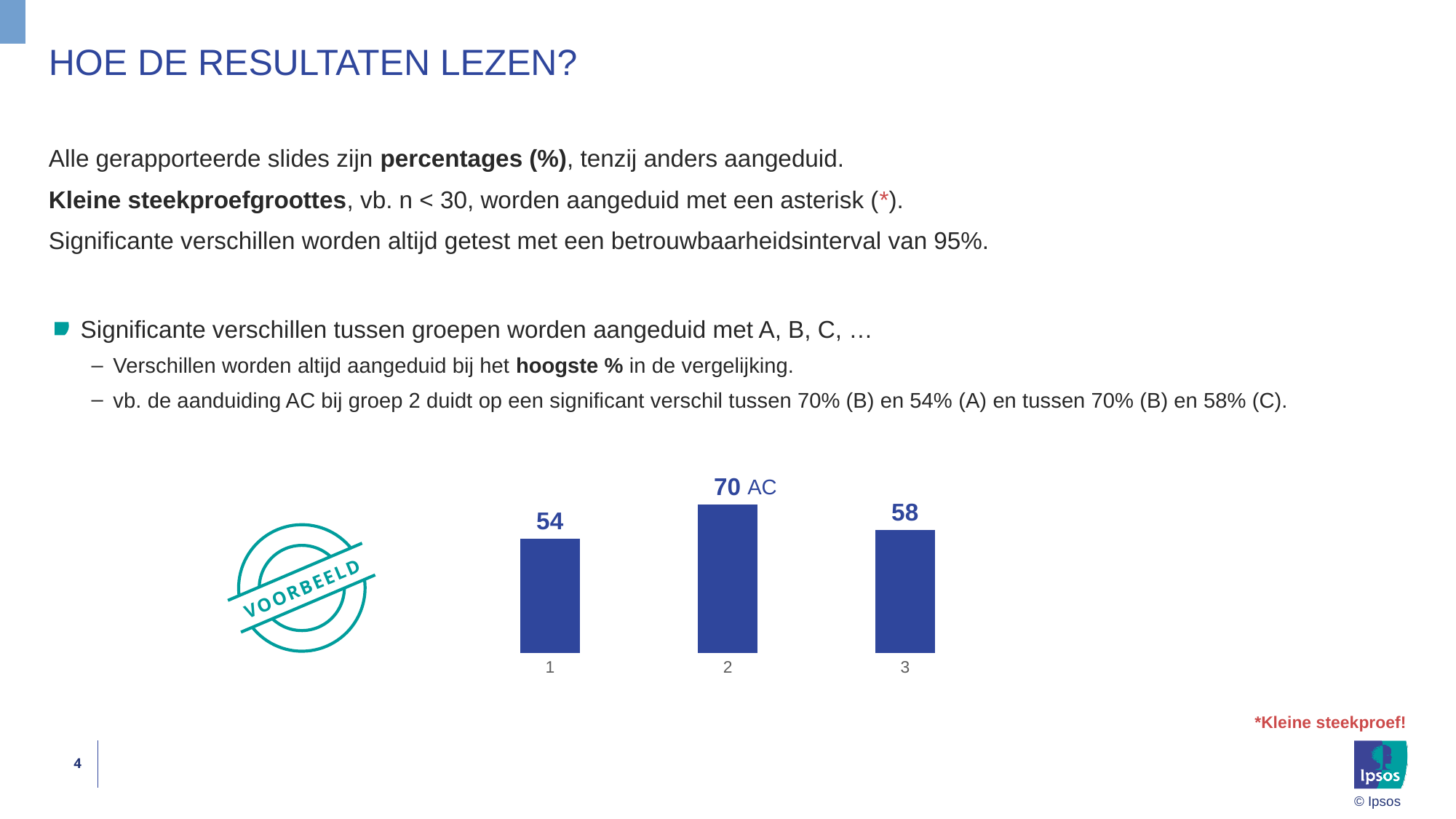
What is the value for category 3? 58 Which is larger, the value for category 2 or the value for category 3? 2 What kind of chart is shown on the slide? bar chart Which category has the highest value? 2 What is the value for category 2? 70 How many bars are shown in the chart? 3 What is the difference between the values for category 2 and category 1? 16 Which category has the lowest value? 1 Which significance letters are printed next to the value for category 2? AC What is the difference between the values for category 3 and category 1? 4 What is the value for category 1? 54 What word is printed on the stamp to the left of the chart? VOORBEELD